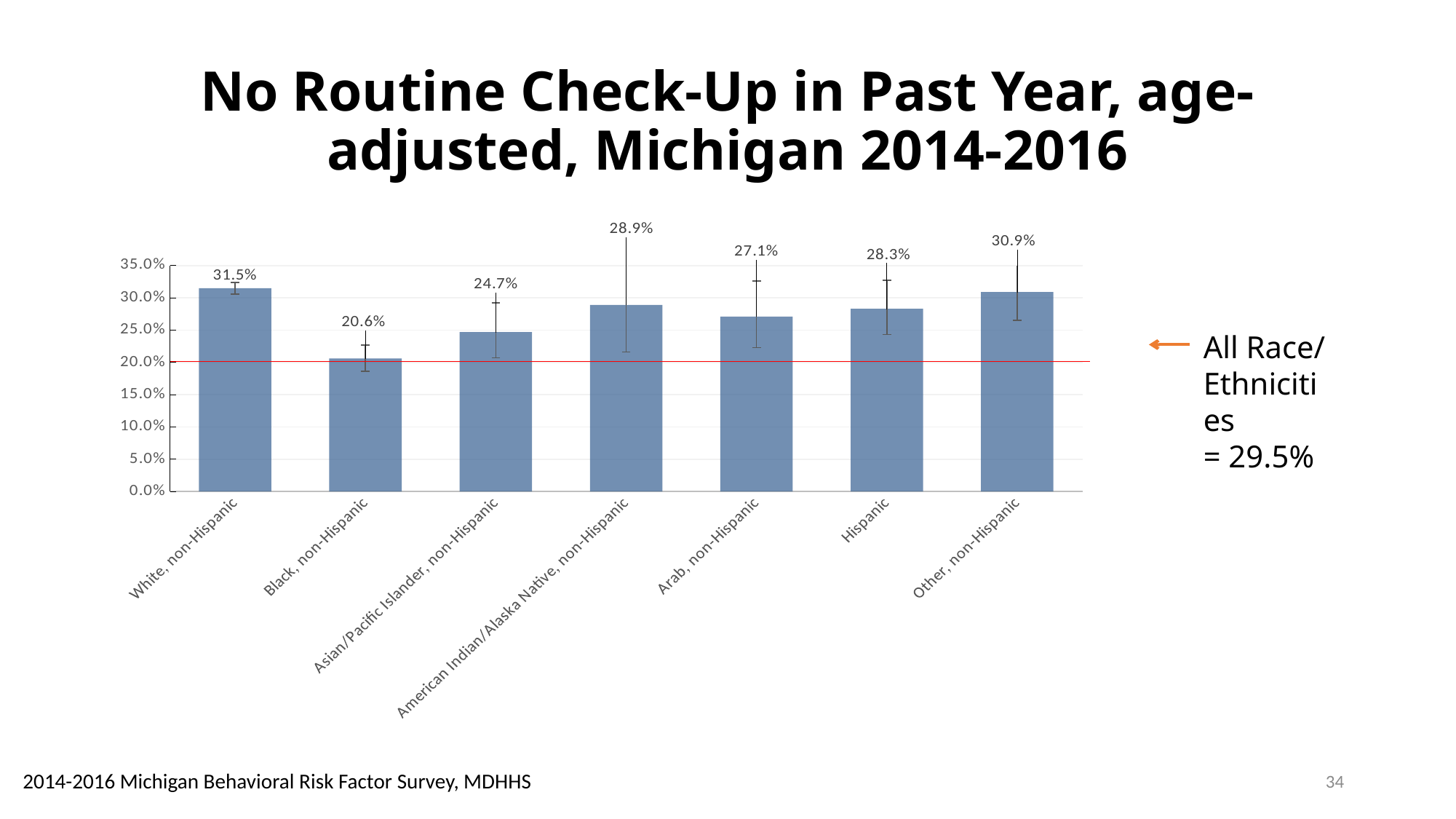
What is the value for Black, non-Hispanic? 20.6% What kind of chart is shown on the slide? bar chart What is the value for White, non-Hispanic? 31.5% What is the value for Asian/Pacific Islander, non-Hispanic? 24.7% According to the text beside the chart, what is the value for All Race/Ethnicities? 29.5% Which category has the highest value? White, non-Hispanic What is the difference between the values for White, non-Hispanic and Black, non-Hispanic? 10.9% What is the value for Hispanic? 28.3% How many race/ethnicity categories are shown on the chart? 7 Which category has the lowest value? Black, non-Hispanic Is the value for American Indian/Alaska Native, non-Hispanic greater or less than 25.0%? greater Which is larger, the value for Arab, non-Hispanic or the value for Other, non-Hispanic? Other, non-Hispanic